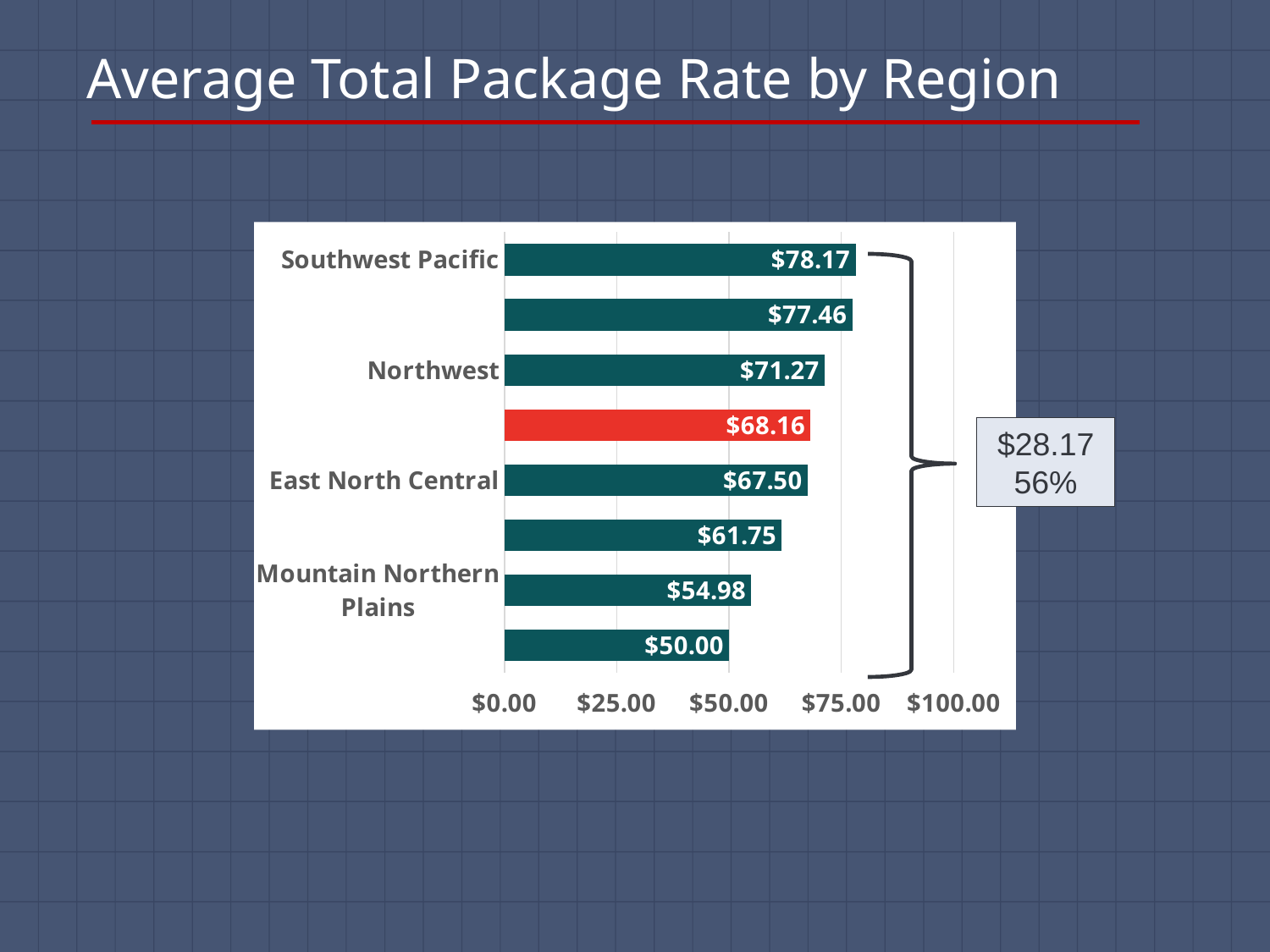
Which region has the highest average total package rate? Southwest Pacific What is the difference between the Southwest Pacific and Mountain Northern Plains values? $23.19 Which is larger, the value for Northwest or the value for East North Central? Northwest What is the average total package rate for East North Central? $67.50 Is the value for Mountain Northern Plains greater or less than $50.00? greater How many bars are shown on the chart? 8 What is the lowest value shown on the chart? $50.00 What is the average total package rate for Southwest Pacific? $78.17 What is the average total package rate for Mountain Northern Plains? $54.98 What value is shown on the red bar? $68.16 What kind of chart is shown on the slide? bar chart What is the average total package rate for Northwest? $71.27